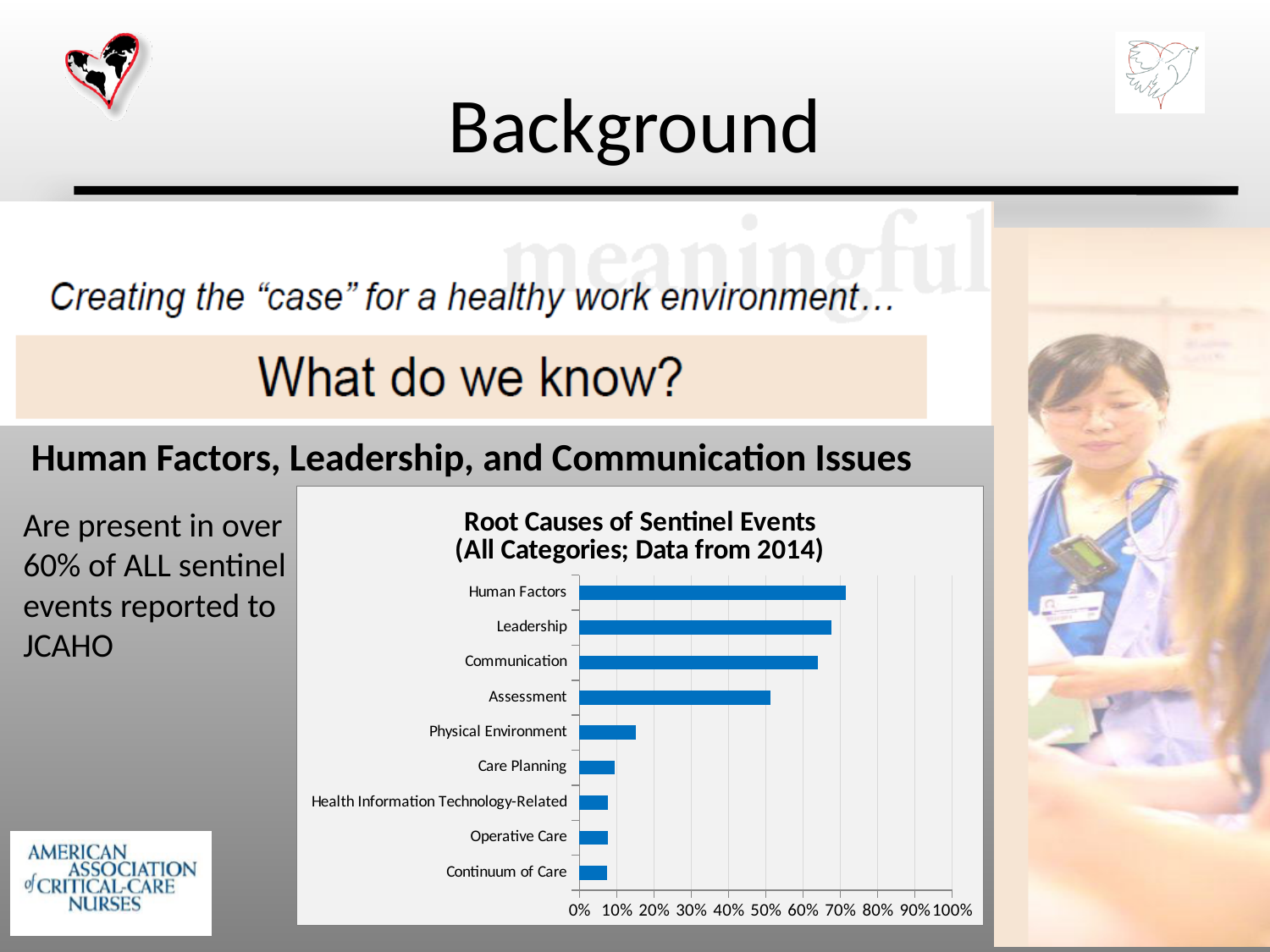
What kind of chart is shown on the slide? bar chart Is the value for Assessment greater or less than 60%? less What is the title of the chart? Root Causes of Sentinel Events (All Categories; Data from 2014) How many root cause categories are plotted in the chart? 9 Is the value for Physical Environment greater or less than 20%? less What is the highest value shown on the horizontal axis of the chart? 100% Is the value for Leadership greater or less than 60%? greater Which is larger, the value for Leadership or the value for Physical Environment? Leadership Which root cause has the highest value in the chart? Human Factors Which is larger, the value for Human Factors or the value for Assessment? Human Factors